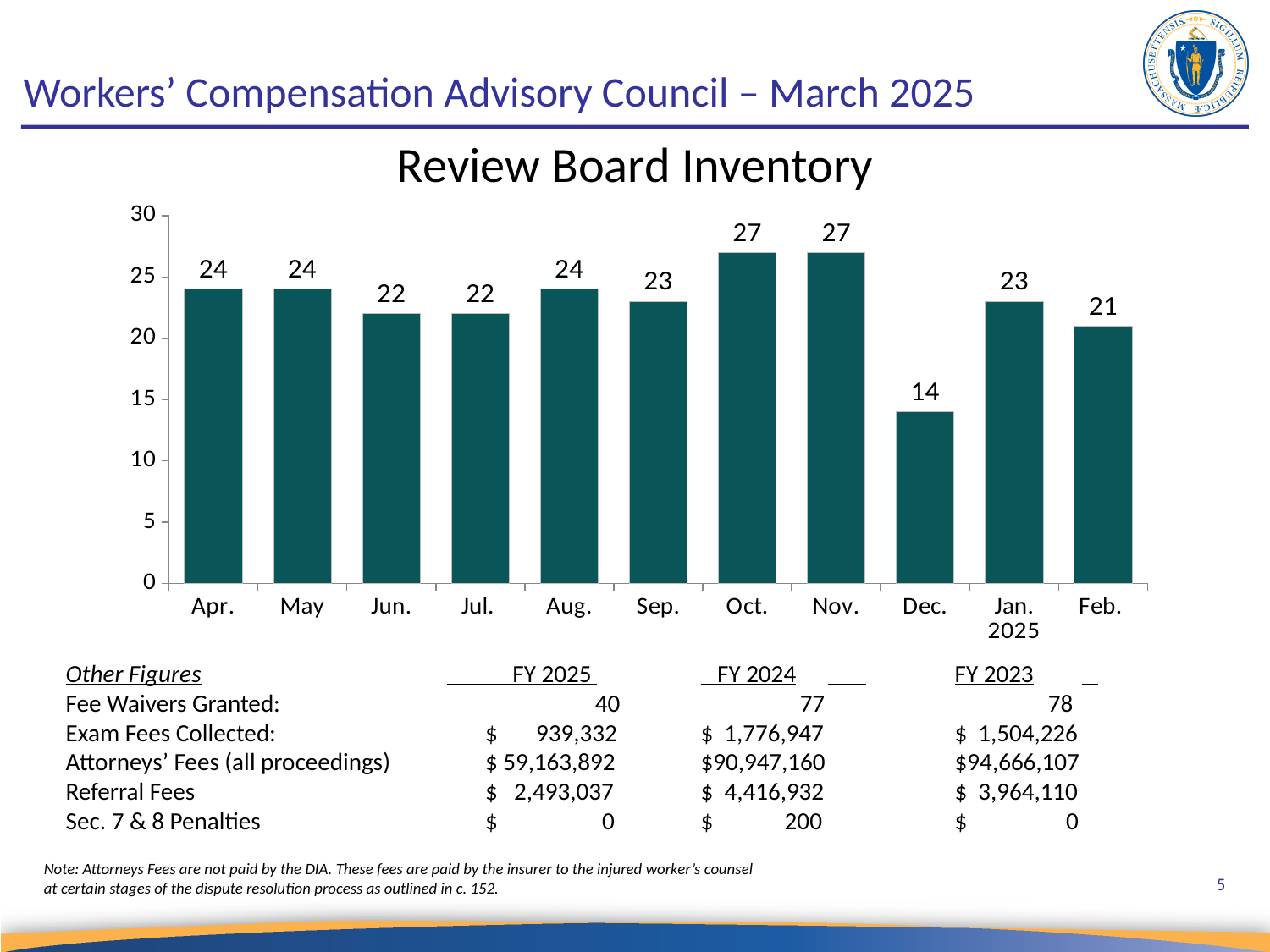
Does the Review Board Inventory rise or fall from Nov. to Dec.? fall Which is larger, the Review Board Inventory for Oct. or for Feb.? Oct. What is the difference between the Review Board Inventory for Apr. and Jun.? 2 How many months are shown on the Review Board Inventory chart? 11 What is the highest Review Board Inventory value shown on the chart? 27 What is the Review Board Inventory value for Sep.? 23 What is the Review Board Inventory value for Feb.? 21 What is the difference between the Review Board Inventory for Nov. and Dec.? 13 What is the Review Board Inventory value for Dec.? 14 Which month has the lowest Review Board Inventory? Dec. Is the Review Board Inventory value for Dec. greater or less than 20? less What kind of chart is the Review Board Inventory chart? bar chart